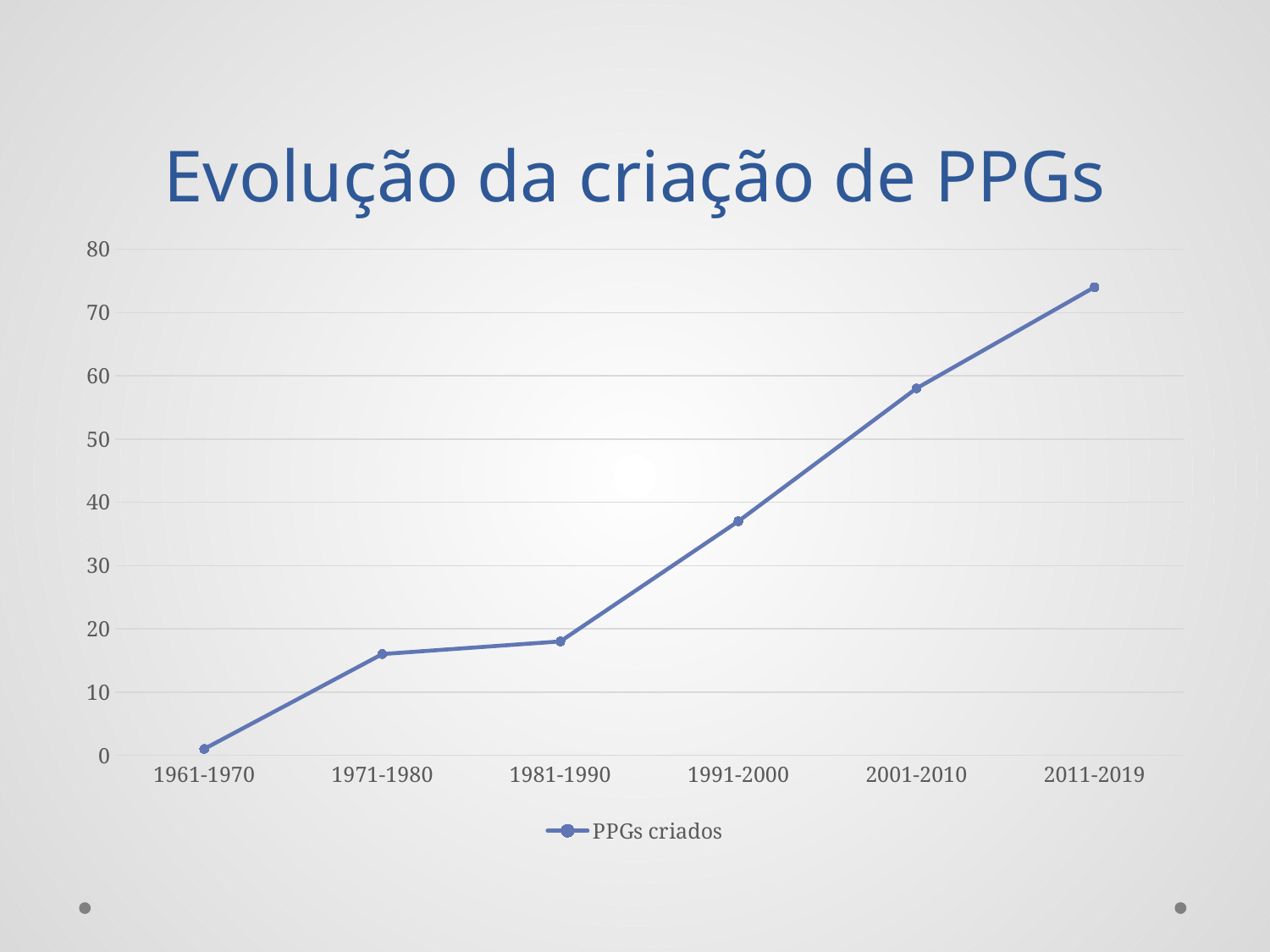
Is the value for 2001-2010 greater or less than 50? greater What is the name of the series shown in the legend? PPGs criados Is the value for 1991-2000 greater or less than 40? less Which period has the lowest value for PPGs criados? 1961-1970 How many series does the legend list? 1 Is the value for 2011-2019 greater or less than 70? greater Which period has the highest value for PPGs criados? 2011-2019 What kind of chart is shown on the slide? line chart How many periods are plotted along the x axis? 6 Which period has the larger value, 1991-2000 or 2001-2010? 2001-2010 Do the values rise or fall from 1961-1970 to 2011-2019? rise What is the title of the chart? Evolução da criação de PPGs